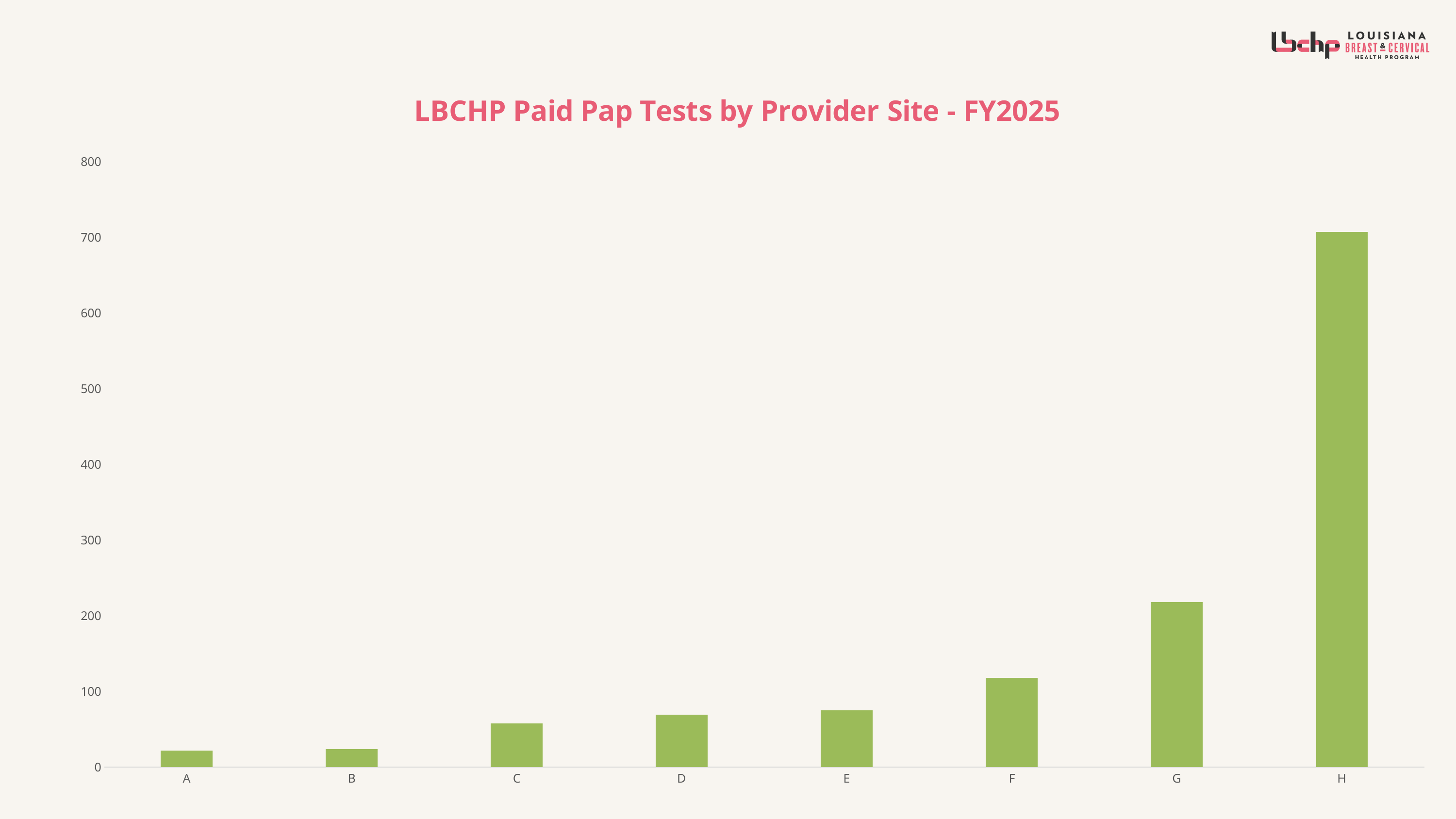
Is the value for provider site F greater or less than 100? greater Which provider site has the highest number of paid Pap tests? H What kind of chart is shown on the slide? bar chart Which has more paid Pap tests, provider site G or provider site F? G Which has more paid Pap tests, provider site D or provider site A? D How many provider sites are shown on the x axis? 8 Is the value for provider site C greater or less than 100? less Is the value for provider site G greater or less than 200? greater Do the values generally rise or fall from provider site A to provider site H? rise What is the title of the chart? LBCHP Paid Pap Tests by Provider Site - FY2025